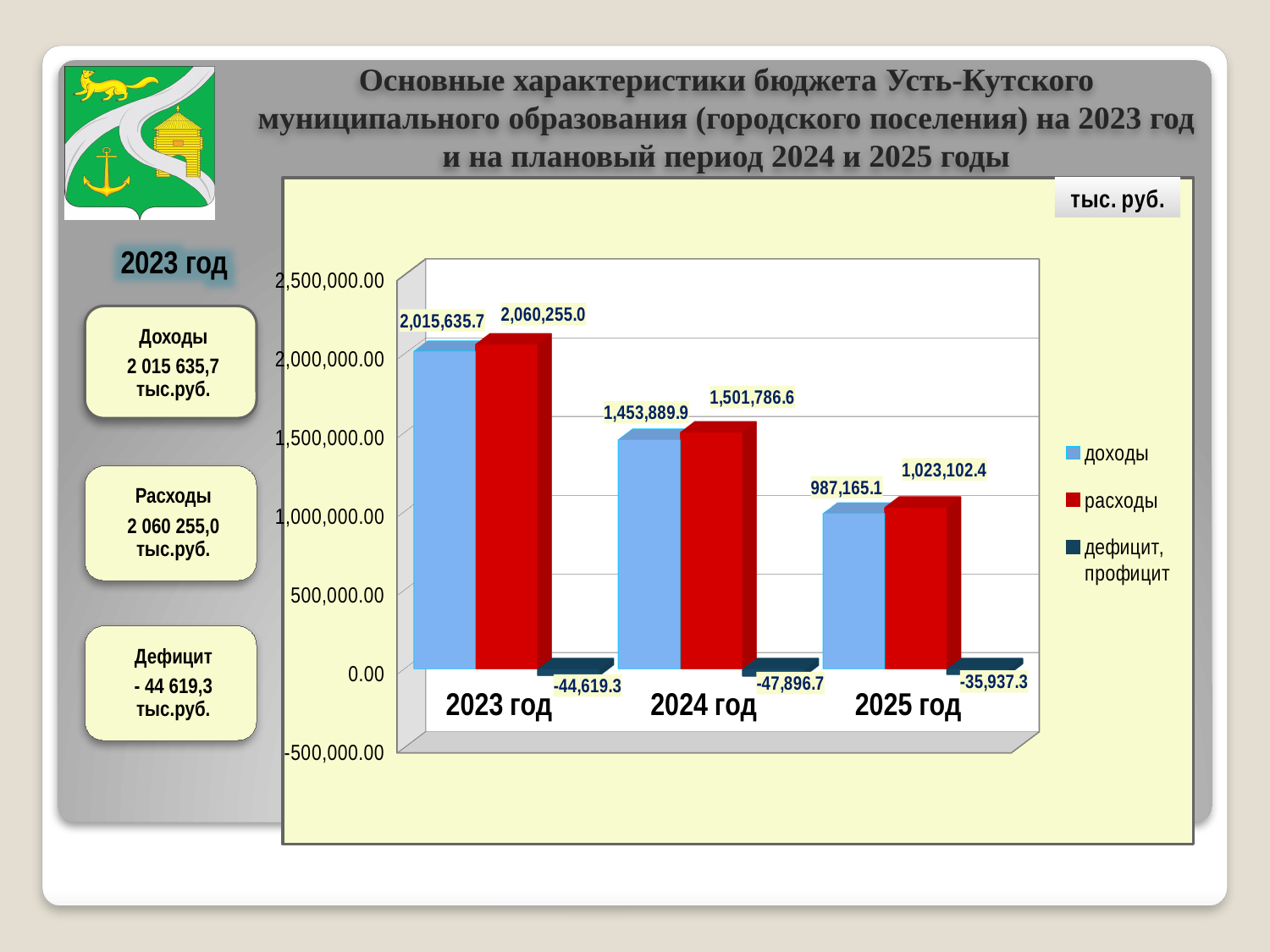
What is the value of дефицит, профицит for 2025 год? -35,937.3 How many years are shown on the x axis of the chart? 3 Is the value of доходы for 2025 год greater or less than 1,000,000.00? less What is the value of доходы for 2023 год? 2,015,635.7 Which year has the highest value of доходы? 2023 год What is the value of расходы for 2024 год? 1,501,786.6 Which is larger for 2023 год, доходы or расходы? расходы How many series does the chart legend list? 3 What is the difference between расходы and доходы for 2024 год? 47,896.7 Which year has the lowest value of расходы? 2025 год Do the values of доходы rise or fall from 2023 год to 2025 год? fall What is the value of расходы for 2025 год? 1,023,102.4